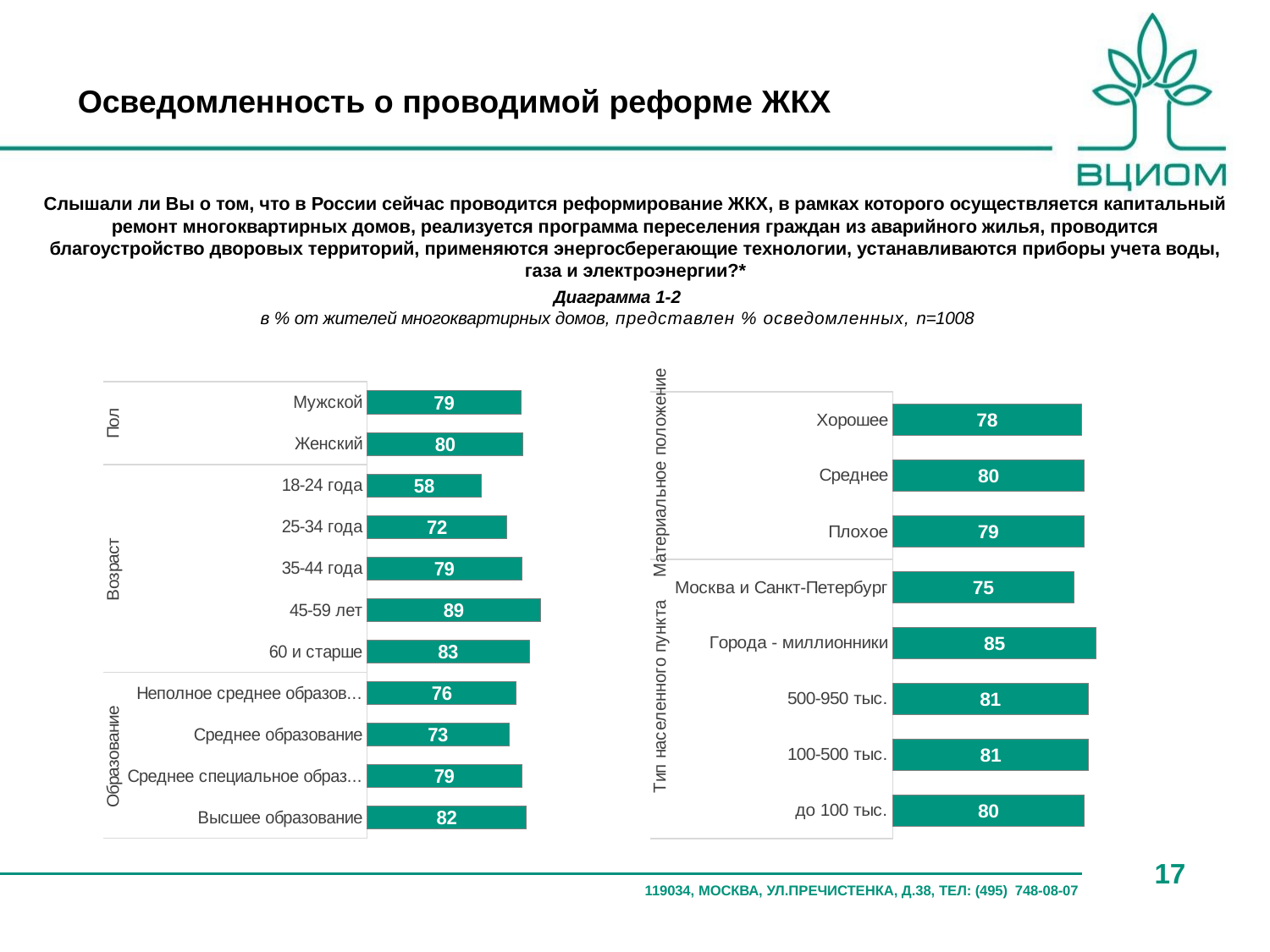
In the right chart, what is the difference between Города - миллионники and Москва и Санкт-Петербург? 10 In the left chart, what is the value for 18-24 года? 58 In the left chart, which is larger: the value for Высшее образование or Среднее образование? Высшее образование In the left chart, which category has the highest value? 45-59 лет In the left chart, what is the difference between the values for 45-59 лет and 18-24 года? 31 In the right chart, what is the value for Города - миллионники? 85 How many categories are plotted in the right chart? 8 In the right chart, what is the value for Москва и Санкт-Петербург? 75 In the right chart, which category has the lowest value? Москва и Санкт-Петербург In the left chart, which category has the lowest value? 18-24 года In the left chart, what is the value for the 45-59 лет category? 89 What type of chart is shown on the left of the slide? Bar chart